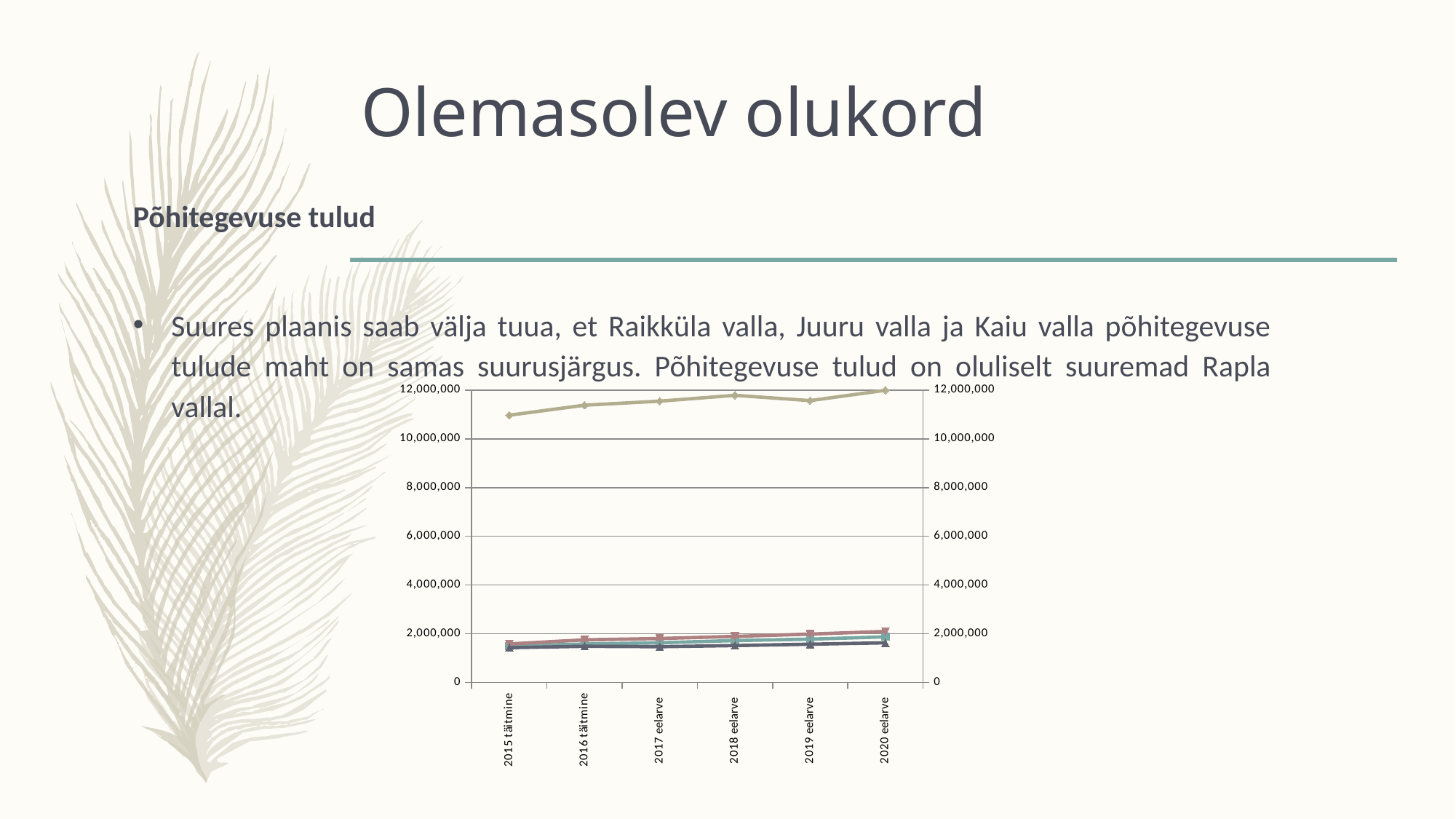
Is the value of the topmost line at 2020 eelarve greater or less than 10,000,000? greater What is the last category on the x axis of the chart? 2020 eelarve What is the first category on the x axis of the chart? 2015 täitmine Is the value of the topmost line at 2015 täitmine greater or less than 10,000,000? greater Is the value of the topmost line at 2017 eelarve greater or less than 12,000,000? less Does the topmost line rise or fall overall from 2015 täitmine to 2020 eelarve? rise How many categories are shown on the x axis of the chart? 6 What kind of chart is shown on the slide? line chart Which category has the highest value for the topmost line? 2020 eelarve Which category has the lowest value for the topmost line? 2015 täitmine